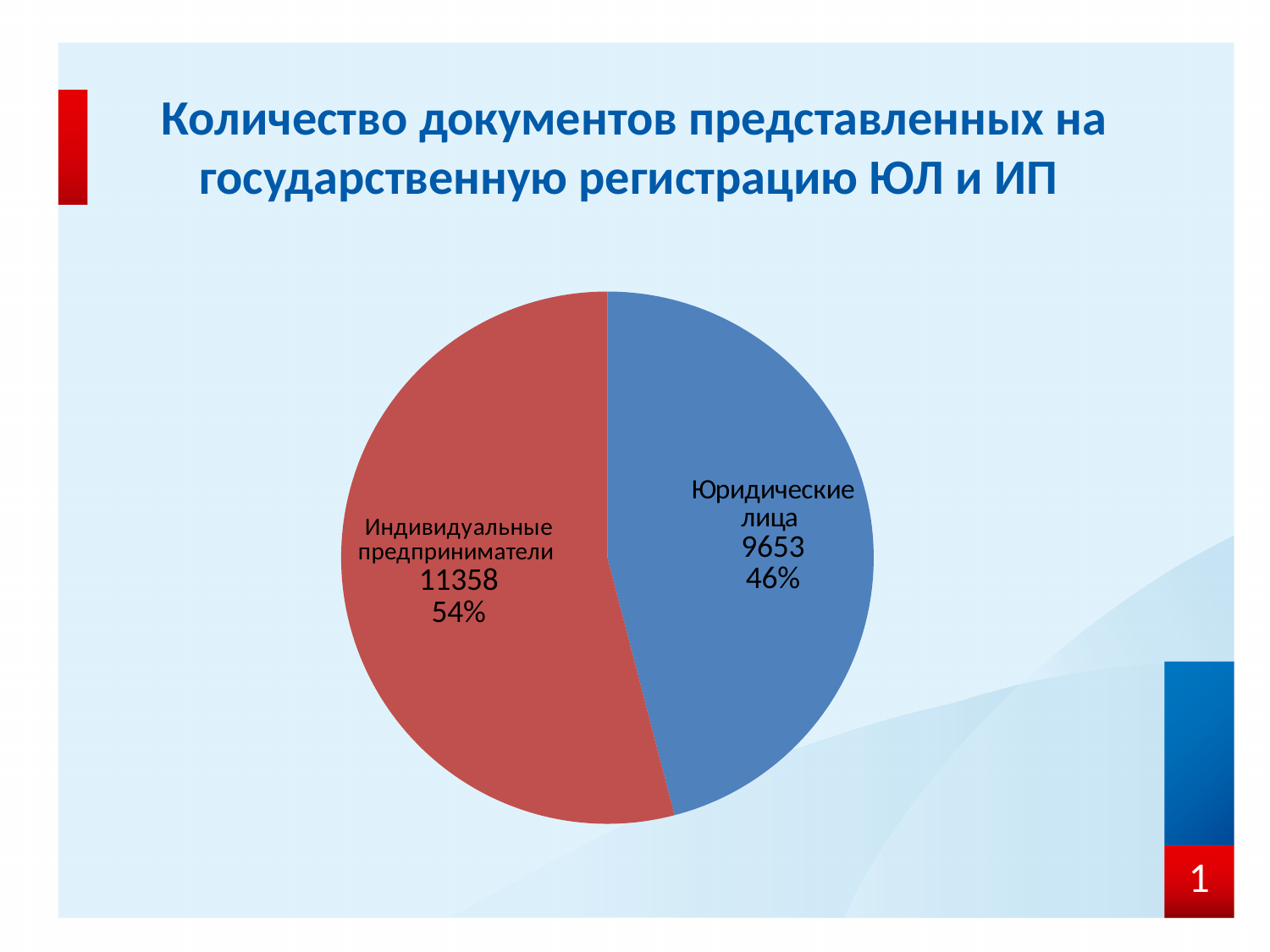
Which category has the smallest slice? Юридические лица What share of the pie does Индивидуальные предприниматели represent? 54% What is the total of the two slices in the pie chart? 21011 What kind of chart is shown on the slide? pie chart What is the difference between the values for Индивидуальные предприниматели and Юридические лица? 1705 What is the value for Индивидуальные предприниматели? 11358 Which category has the largest slice? Индивидуальные предприниматели What is the value for Юридические лица? 9653 How many slices does the pie chart have? 2 Which is larger, the value for Юридические лица or the value for Индивидуальные предприниматели? Индивидуальные предприниматели What colour is the slice for Юридические лица? blue What share of the pie does Юридические лица represent? 46%